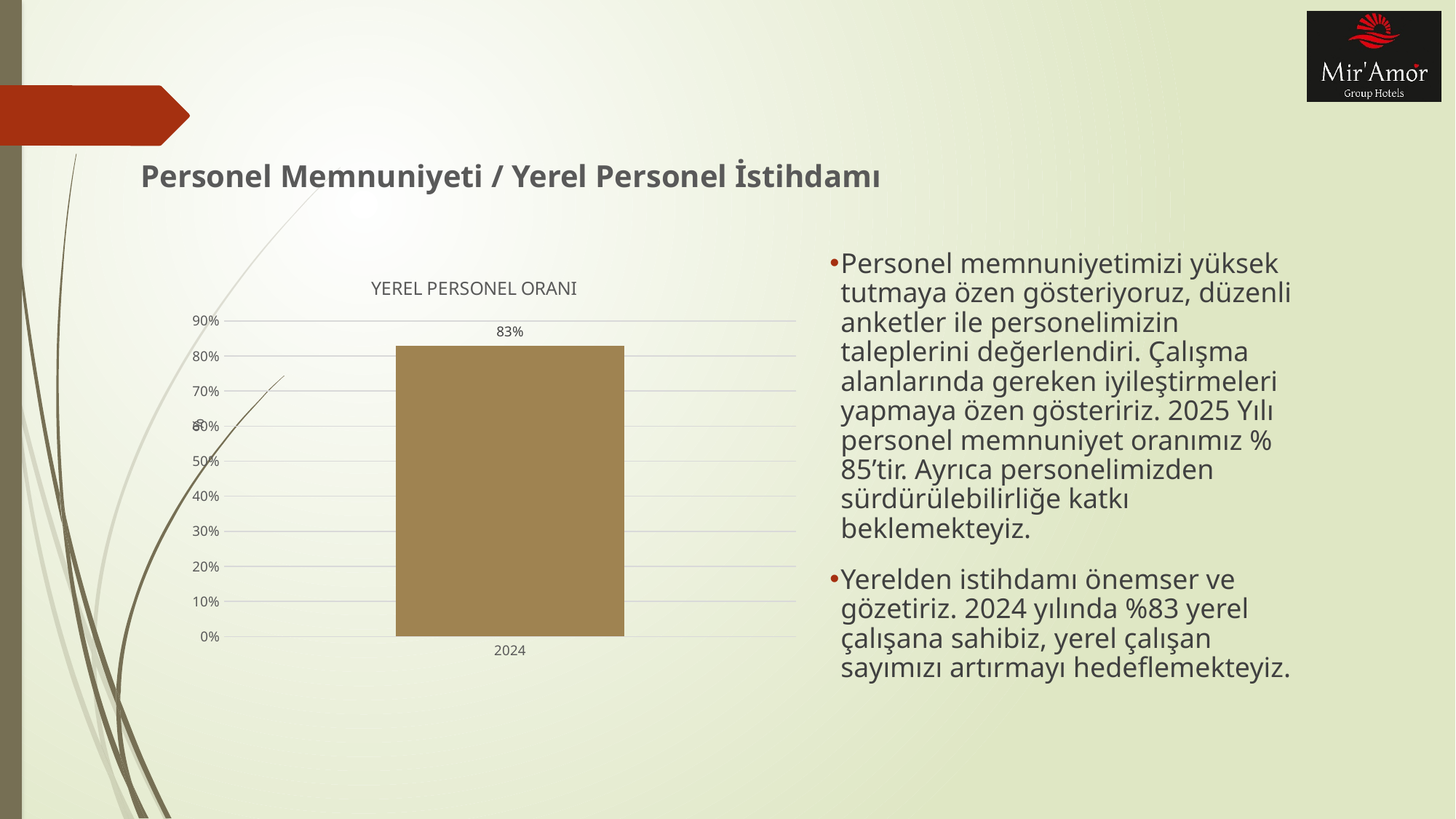
What is the highest value shown on the y axis of the chart? 90% What is the title of the chart on the slide? YEREL PERSONEL ORANI Is the value for 2024 greater or less than 90%? less Is the value for 2024 greater or less than 80%? greater What kind of chart is shown on the slide? bar chart How many categories are plotted in the YEREL PERSONEL ORANI chart? 1 Which year is shown on the x axis of the chart? 2024 What is the value for 2024 in the YEREL PERSONEL ORANI chart? 83%